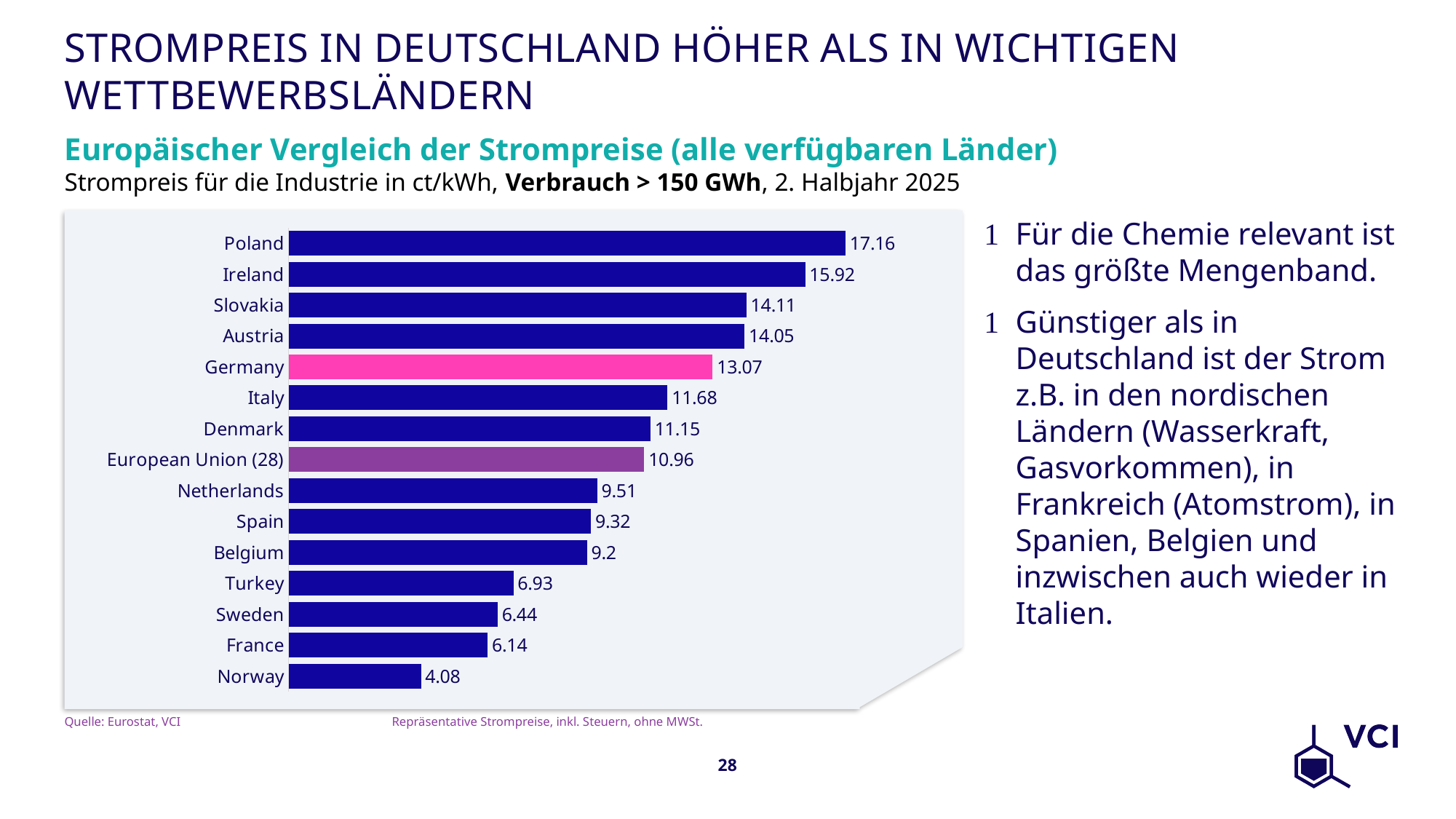
What is the difference between the values for Poland and Germany? 4.09 Which country has the highest electricity price in the chart? Poland What value is shown for European Union (28)? 10.96 What is the difference between the values for Germany and France? 6.93 Which bar is highlighted in pink in the chart? Germany Which has a higher value, Italy or Denmark? Italy What kind of chart is shown on the slide? Bar chart What value is shown for Netherlands? 9.51 How many countries or regions are shown in the chart? 15 Which country has the lowest electricity price in the chart? Norway Which has a higher value, Sweden or Turkey? Turkey What is the electricity price shown for Germany? 13.07